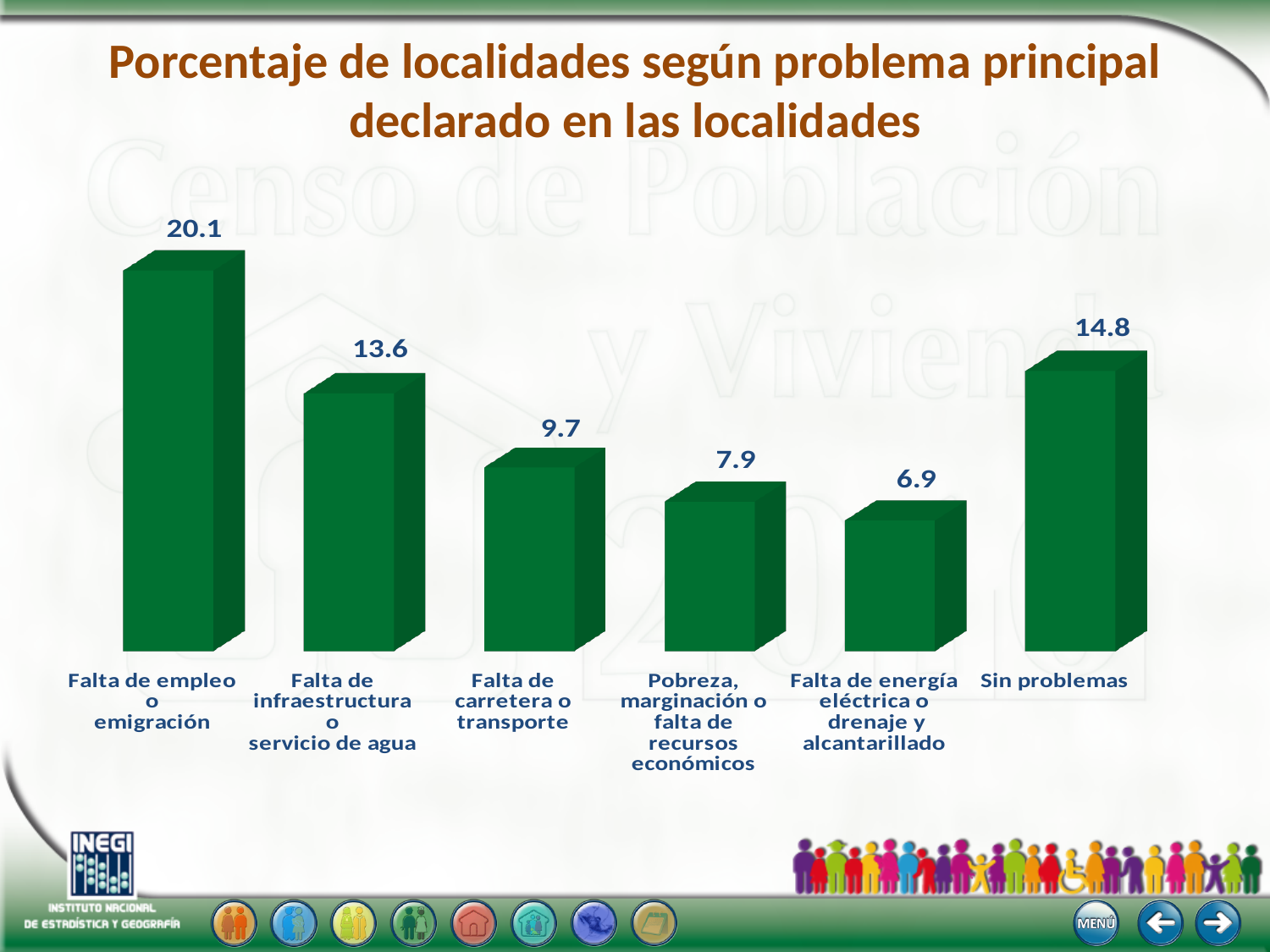
What is the value for "Falta de carretera o transporte"? 9.7 Which is larger: the value for "Sin problemas" or the value for "Falta de infraestructura o servicio de agua"? Sin problemas What is the difference between the values for "Falta de empleo o emigración" and "Falta de infraestructura o servicio de agua"? 6.5 What is the difference between the values for "Sin problemas" and "Falta de energía eléctrica o drenaje y alcantarillado"? 7.9 What is the value for "Falta de empleo o emigración"? 20.1 What is the title of the chart? Porcentaje de localidades según problema principal declarado en las localidades What kind of chart is shown on the slide? Bar chart How many categories are shown in the chart? 6 Which category has the highest value? Falta de empleo o emigración What is the value for "Sin problemas"? 14.8 Which category has the lowest value? Falta de energía eléctrica o drenaje y alcantarillado Which is larger: the value for "Pobreza, marginación o falta de recursos económicos" or the value for "Falta de carretera o transporte"? Falta de carretera o transporte